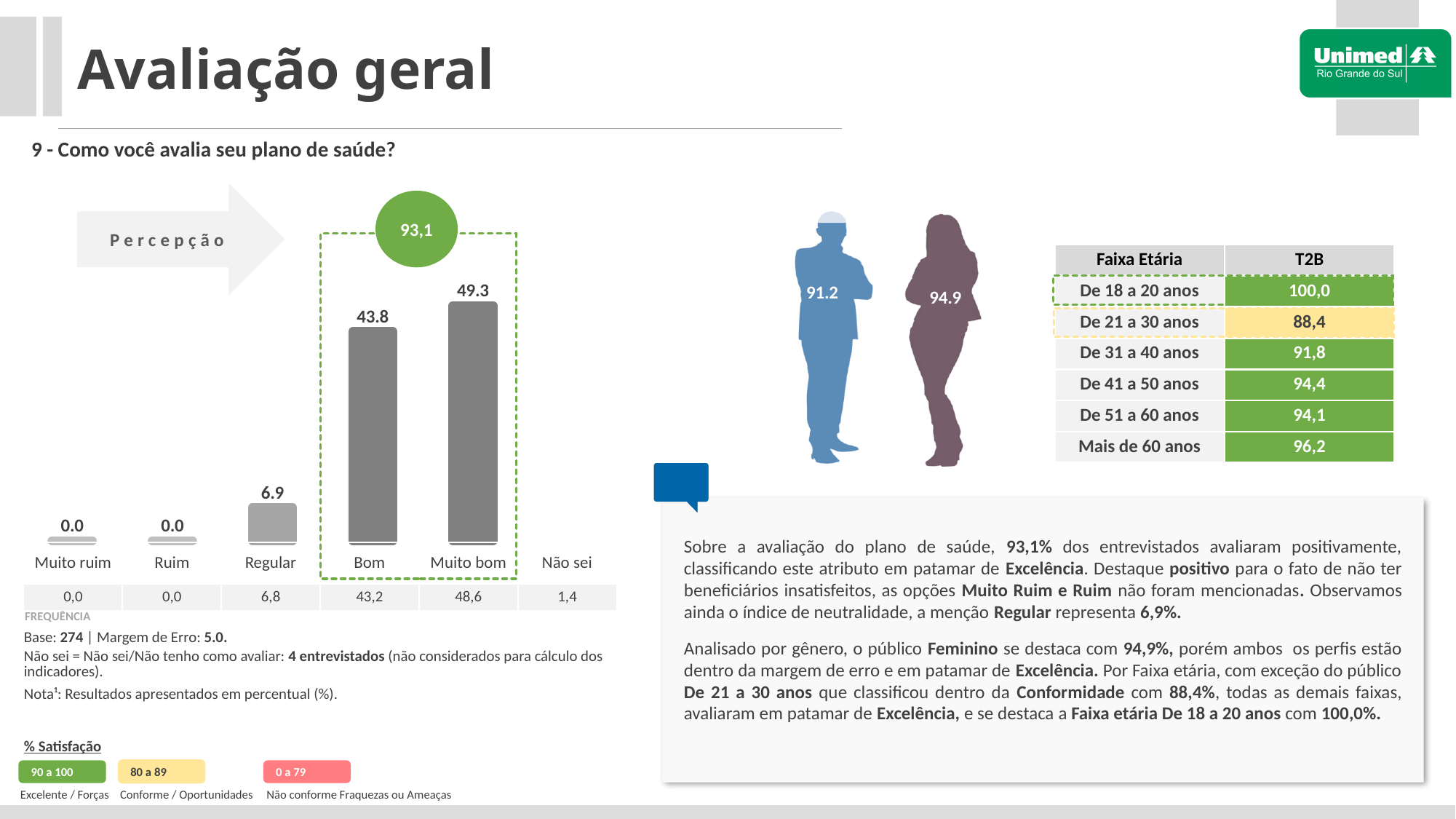
What is the difference between the Muito bom value and the Bom value? 5.5 What value is printed in the green circle above the dashed box in the chart? 93,1 What is the combined value of the Bom and Muito bom bars? 93.1 What is the value shown for the Regular bar? 6.9 What is the value shown for the Muito bom bar? 49.3 What is the value shown for Muito ruim? 0.0 What is the value shown for the Bom bar? 43.8 Do the bar values rise or fall from Muito ruim to Muito bom along the x axis? rise What is the difference between the Bom value and the Regular value? 36.9 What kind of chart is shown on the slide? bar chart Which category has the highest bar in the chart? Muito bom Which is larger, the value for Bom or the value for Regular? Bom